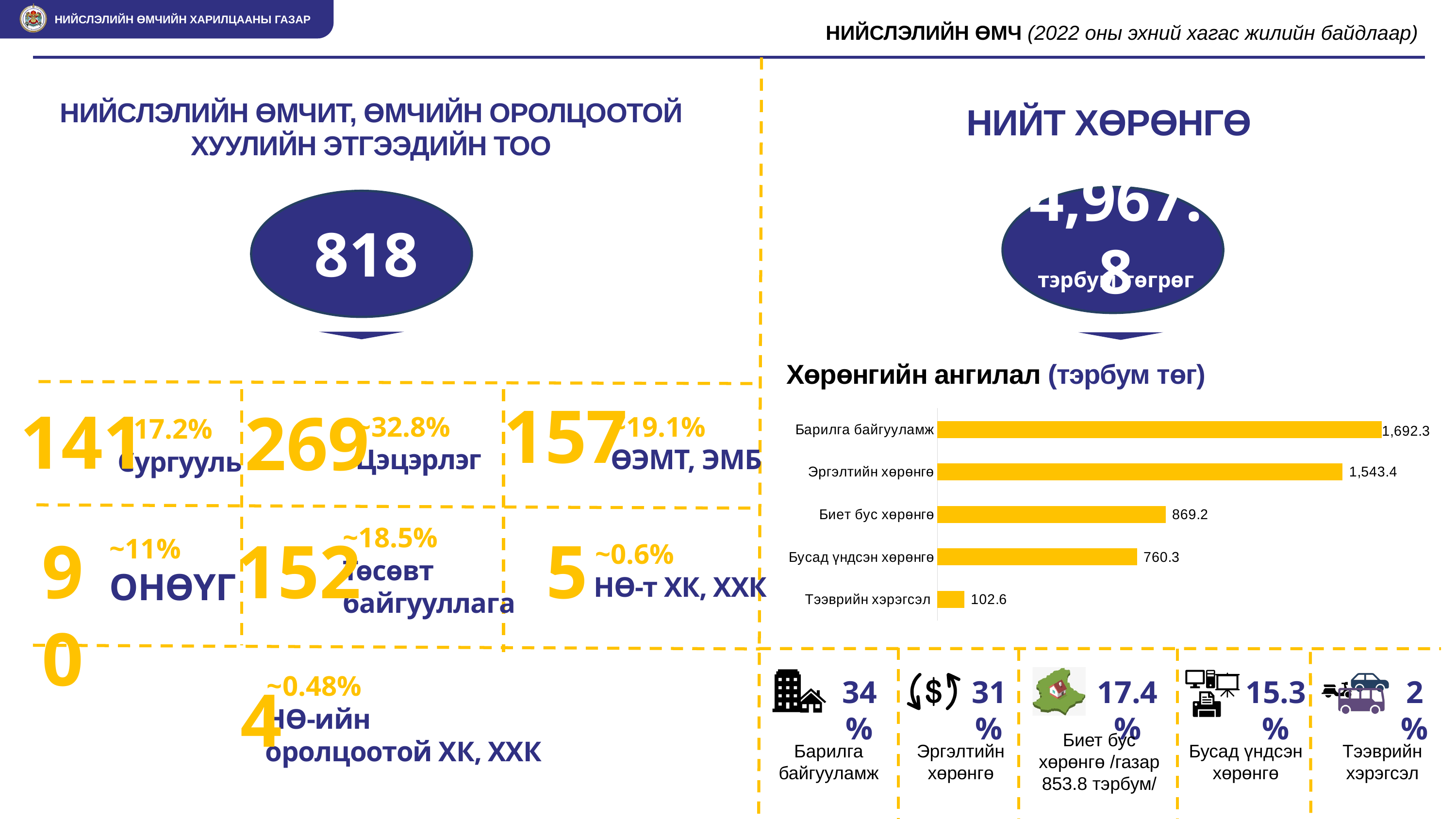
How many categories are shown in the chart 'Хөрөнгийн ангилал (тэрбум төг)'? 5 In the chart 'Хөрөнгийн ангилал (тэрбум төг)', which is larger: Биет бус хөрөнгө or Бусад үндсэн хөрөнгө? Биет бус хөрөнгө In the chart 'Хөрөнгийн ангилал (тэрбум төг)', which category has the lowest value? Тээврийн хэрэгсэл In the chart 'Хөрөнгийн ангилал (тэрбум төг)', what is the value for Эргэлтийн хөрөнгө? 1,543.4 In the chart 'Хөрөнгийн ангилал (тэрбум төг)', which category has the highest value? Барилга байгууламж In the chart 'Хөрөнгийн ангилал (тэрбум төг)', what is the difference between Барилга байгууламж and Эргэлтийн хөрөнгө? 148.9 In the chart 'Хөрөнгийн ангилал (тэрбум төг)', what is the value for Тээврийн хэрэгсэл? 102.6 In the chart 'Хөрөнгийн ангилал (тэрбум төг)', what is the difference between Биет бус хөрөнгө and Бусад үндсэн хөрөнгө? 108.9 In the chart 'Хөрөнгийн ангилал (тэрбум төг)', what is the value for Биет бус хөрөнгө? 869.2 What unit is given in the title of the chart 'Хөрөнгийн ангилал'? тэрбум төг In the chart 'Хөрөнгийн ангилал (тэрбум төг)', what is the value for Барилга байгууламж? 1,692.3 What type of chart is 'Хөрөнгийн ангилал (тэрбум төг)'? Bar chart